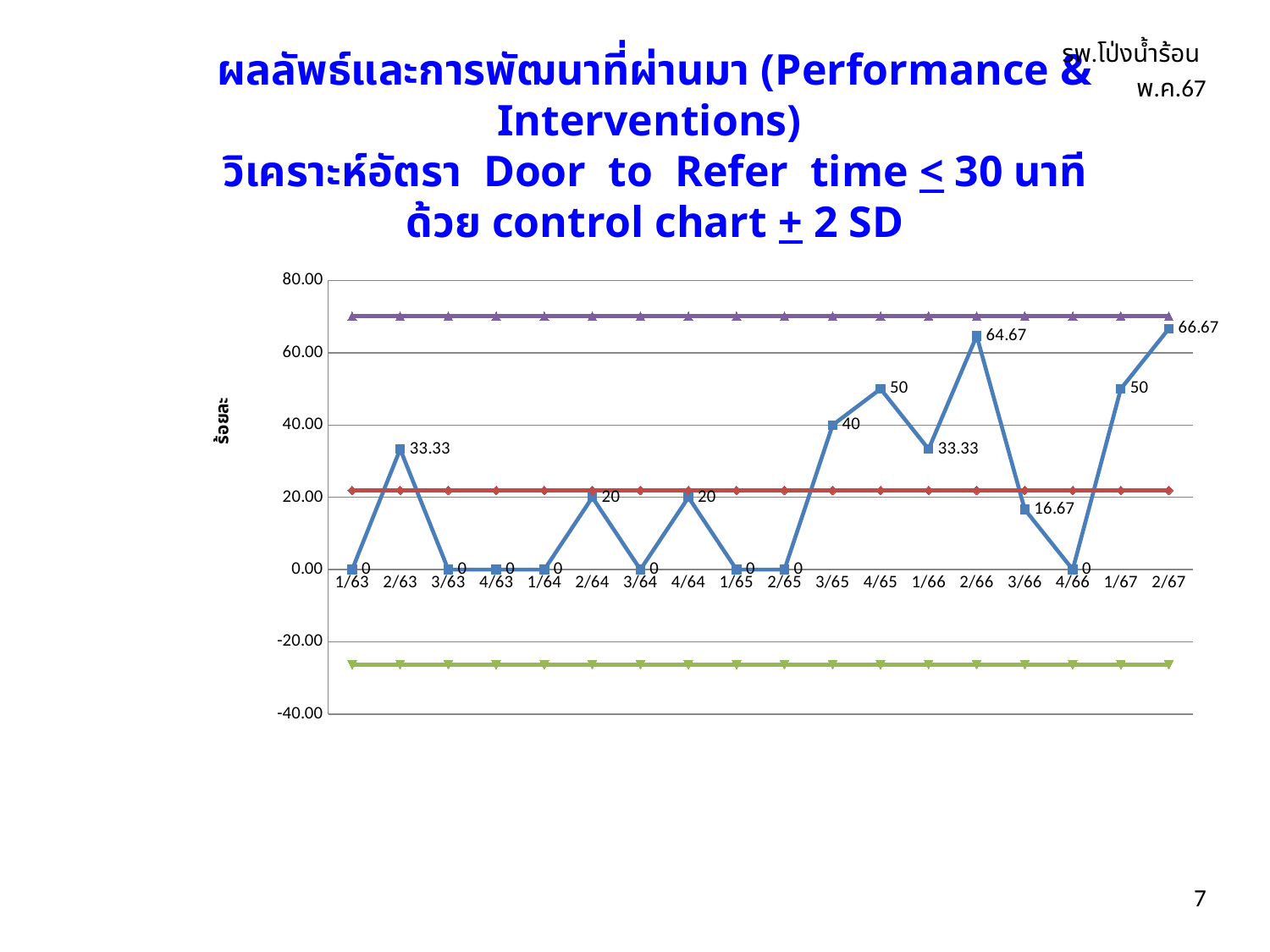
What kind of chart is shown on the slide? line chart Which period has the highest value on the data line? 2/67 Is the upper control line (triangle markers) greater or less than 60.00? greater What is the value for 2/66? 64.67 What is the label on the y axis? ร้อยละ What is the difference between the values for 2/67 and 2/66? 2 What is the value for 3/65? 40 What is the value for 3/66? 16.67 Which is larger, the value for 4/65 or the value for 1/66? 4/65 What is the value for 2/63? 33.33 What is the difference between the values for 4/65 and 3/65? 10 How many periods are shown on the x axis? 18